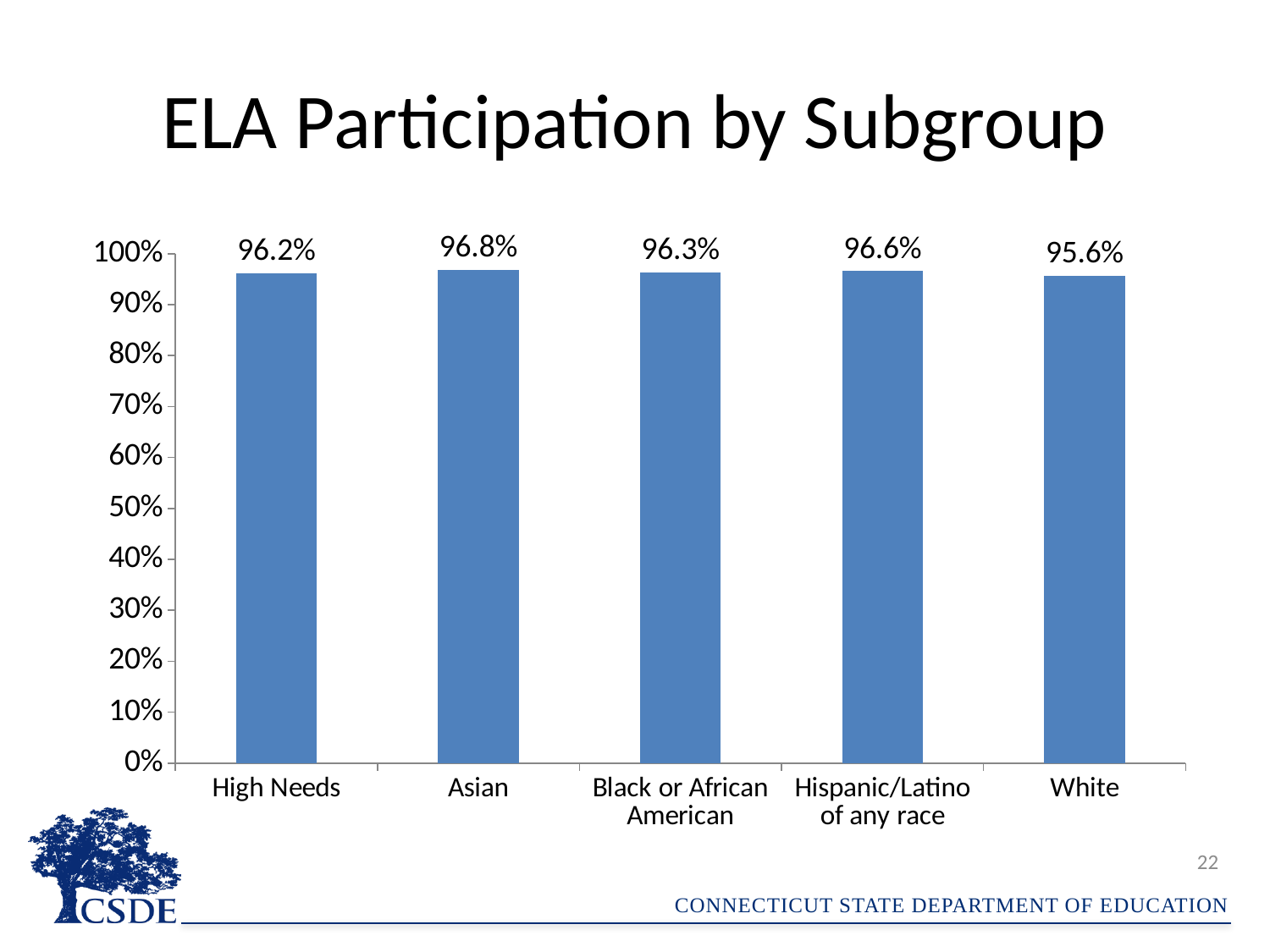
What is the difference in ELA participation between the Asian and White subgroups? 1.2 percentage points What is the ELA participation rate for the White subgroup? 95.6% What is the ELA participation rate for the Asian subgroup? 96.8% What is the title of the chart? ELA Participation by Subgroup What is the ELA participation rate for the Hispanic/Latino of any race subgroup? 96.6% What is the ELA participation rate for High Needs students? 96.2% What is the ELA participation rate for the Black or African American subgroup? 96.3% Which subgroup has the highest ELA participation rate? Asian Which subgroup has a higher ELA participation rate, Hispanic/Latino of any race or High Needs? Hispanic/Latino of any race How many subgroups are shown in the chart? 5 What type of chart is used to show ELA participation by subgroup? Bar chart Which subgroup has the lowest ELA participation rate? White